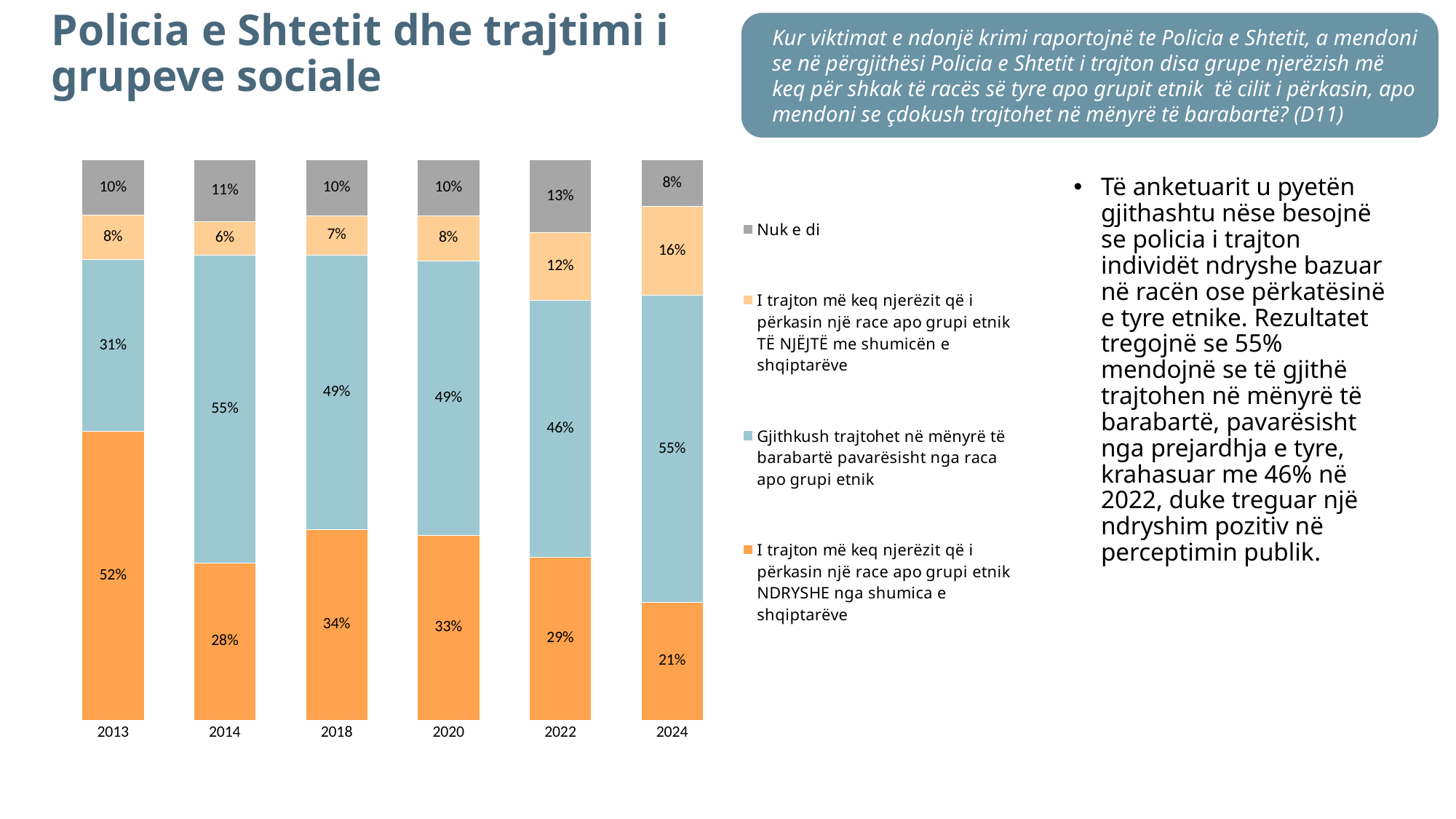
How many years are shown on the x axis of the chart? 6 In 2013, what share said the police treat worse people of a race or ethnic group 'NDRYSHE nga shumica e shqiptarëve'? 52% How many series does the chart legend list? 4 Which year has the larger 'Gjithkush trajtohet në mënyrë të barabartë' share, 2022 or 2024? 2024 What percentage of respondents in 2024 said 'Gjithkush trajtohet në mënyrë të barabartë pavarësisht nga raca apo grupi etnik'? 55% What kind of chart is shown on the slide? Stacked bar chart In which year is the 'NDRYSHE nga shumica e shqiptarëve' segment the largest? 2013 What is the value for the 'TË NJËJTË me shumicën e shqiptarëve' series in 2024? 16% By how many percentage points did the 'NDRYSHE nga shumica e shqiptarëve' share fall from 2013 to 2024? 31 percentage points What is the 'Nuk e di' value for 2022? 13% Does the 'NDRYSHE nga shumica e shqiptarëve' share rise or fall from 2018 to 2024? Fall In which year is the 'Nuk e di' segment the smallest? 2024